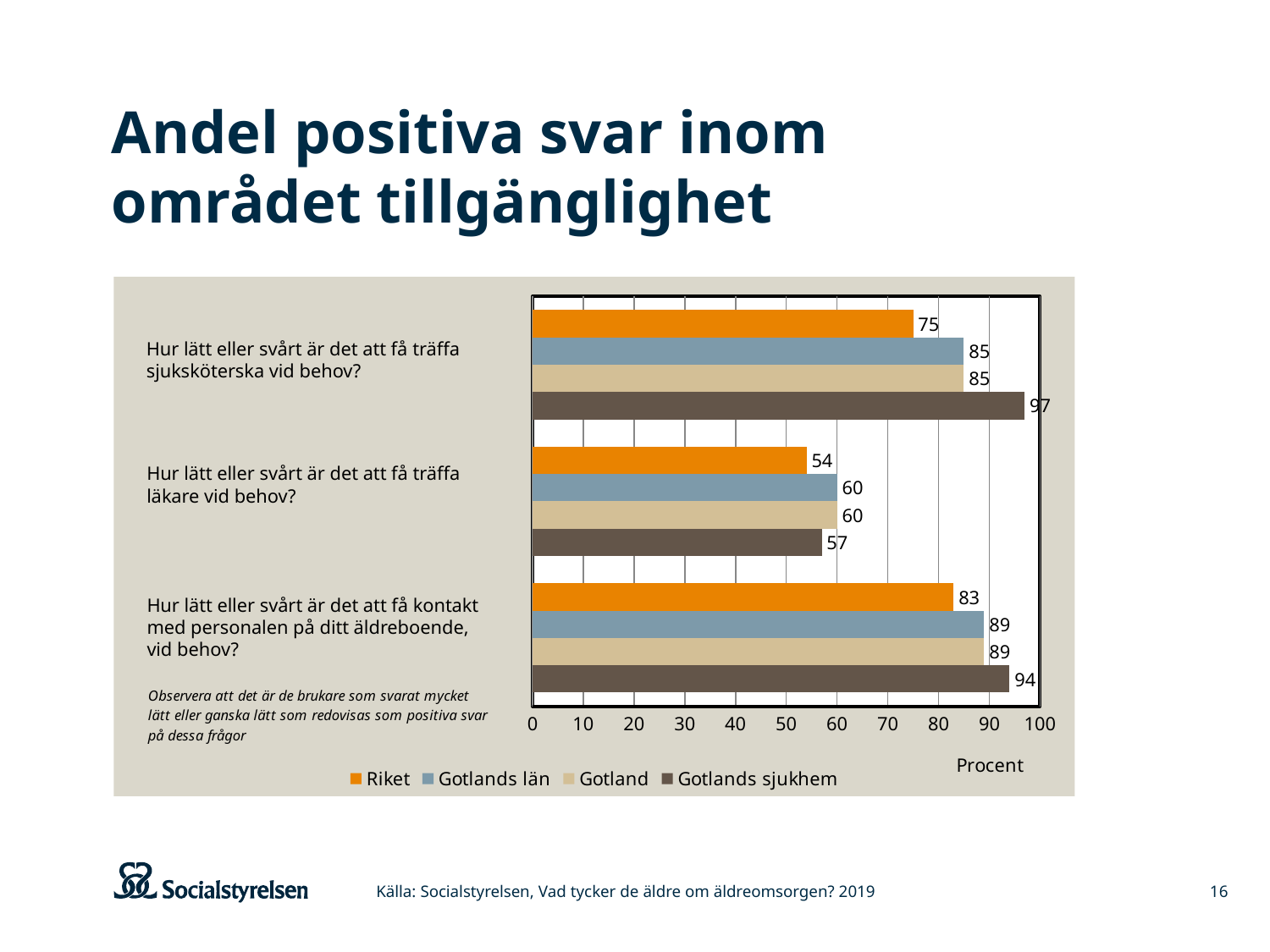
What kind of chart is shown on the slide? Bar chart How many questions (categories) are shown on the chart? 3 What is the value for Gotlands sjukhem on the question "Hur lätt eller svårt är det att få träffa sjuksköterska vid behov?"? 97 Which series has the highest value for the question about getting in contact with staff at the care home ("få kontakt med personalen på ditt äldreboende")? Gotlands sjukhem Which series has the lowest value for the question about meeting a doctor ("få träffa läkare vid behov")? Riket How many series does the legend list? 4 Which is larger for the question about meeting a doctor: the value for Gotlands län or the value for Gotlands sjukhem? Gotlands län What unit is shown on the horizontal axis of the chart? Procent What is the value for Gotland on the question "Hur lätt eller svårt är det att få kontakt med personalen på ditt äldreboende, vid behov?"? 89 What is the value for Riket on the question "Hur lätt eller svårt är det att få träffa läkare vid behov?"? 54 What is the difference between Gotlands sjukhem and Riket for the question about meeting a nurse ("få träffa sjuksköterska vid behov")? 22 Is the value for Riket on the question about meeting a nurse greater or less than 70? greater